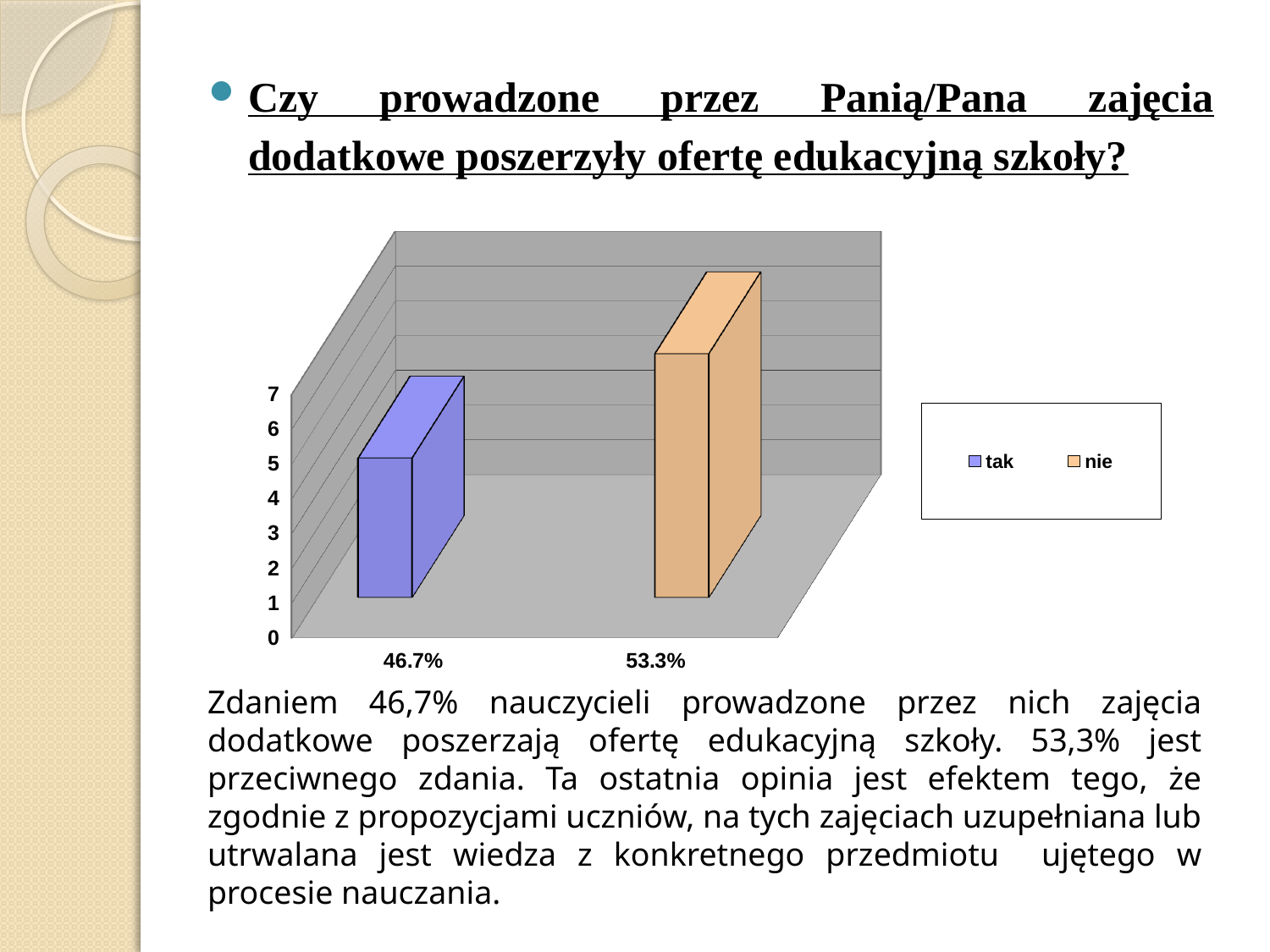
How many bars are plotted in the chart? 2 What type of chart is shown on the slide? bar chart Which category has the highest bar in the chart? nie Is the value for tak greater or less than 2? greater Is the value for nie greater or less than 3? greater Which category has the taller bar, tak or nie? nie What are the two entries listed in the chart legend? tak, nie What percentage label is shown beneath the tak bar? 46.7% What percentage label is shown beneath the nie bar? 53.3% Which category has the lowest bar in the chart? tak What colour is the bar for tak? blue How many series does the chart legend list? 2